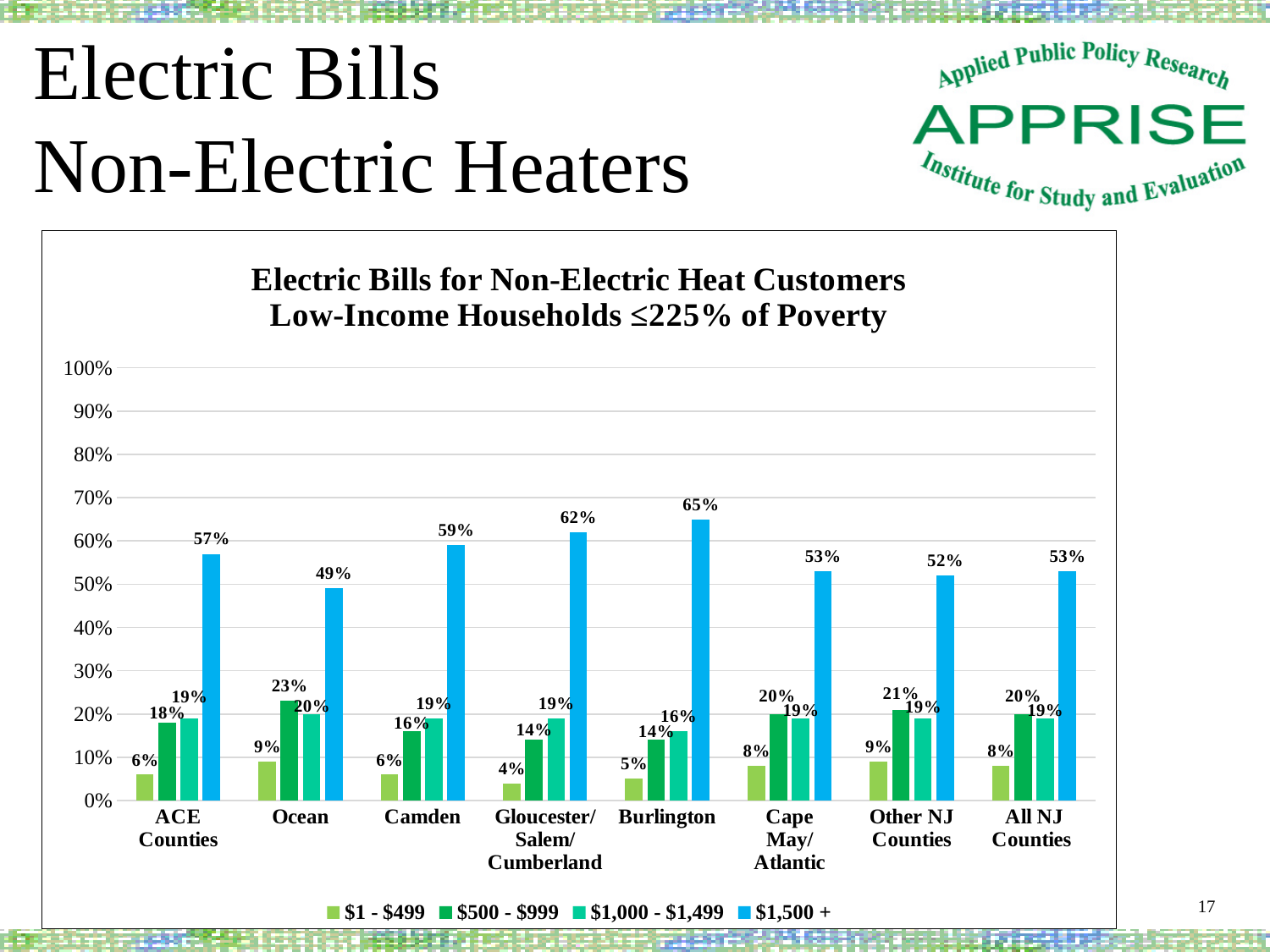
What is the value for the $1 - $499 series in Gloucester/Salem/Cumberland? 4% Which has a larger $500 - $999 value, Ocean or Camden? Ocean Which category has the highest value for the $1,500 + series? Burlington What is the difference between the $1,500 + values for Burlington and Ocean? 16 percentage points What kind of chart is shown on the slide? Bar chart How many categories are shown on the x axis? 8 Which category has the lowest value for the $1,500 + series? Ocean What percentage of Burlington customers have electric bills of $1,500 +? 65% How many series does the legend list? 4 Is the $1,500 + value for Camden greater or less than 50%? greater What is the value for the $500 - $999 series in Other NJ Counties? 21% What is the title of the chart? Electric Bills for Non-Electric Heat Customers Low-Income Households ≤225% of Poverty